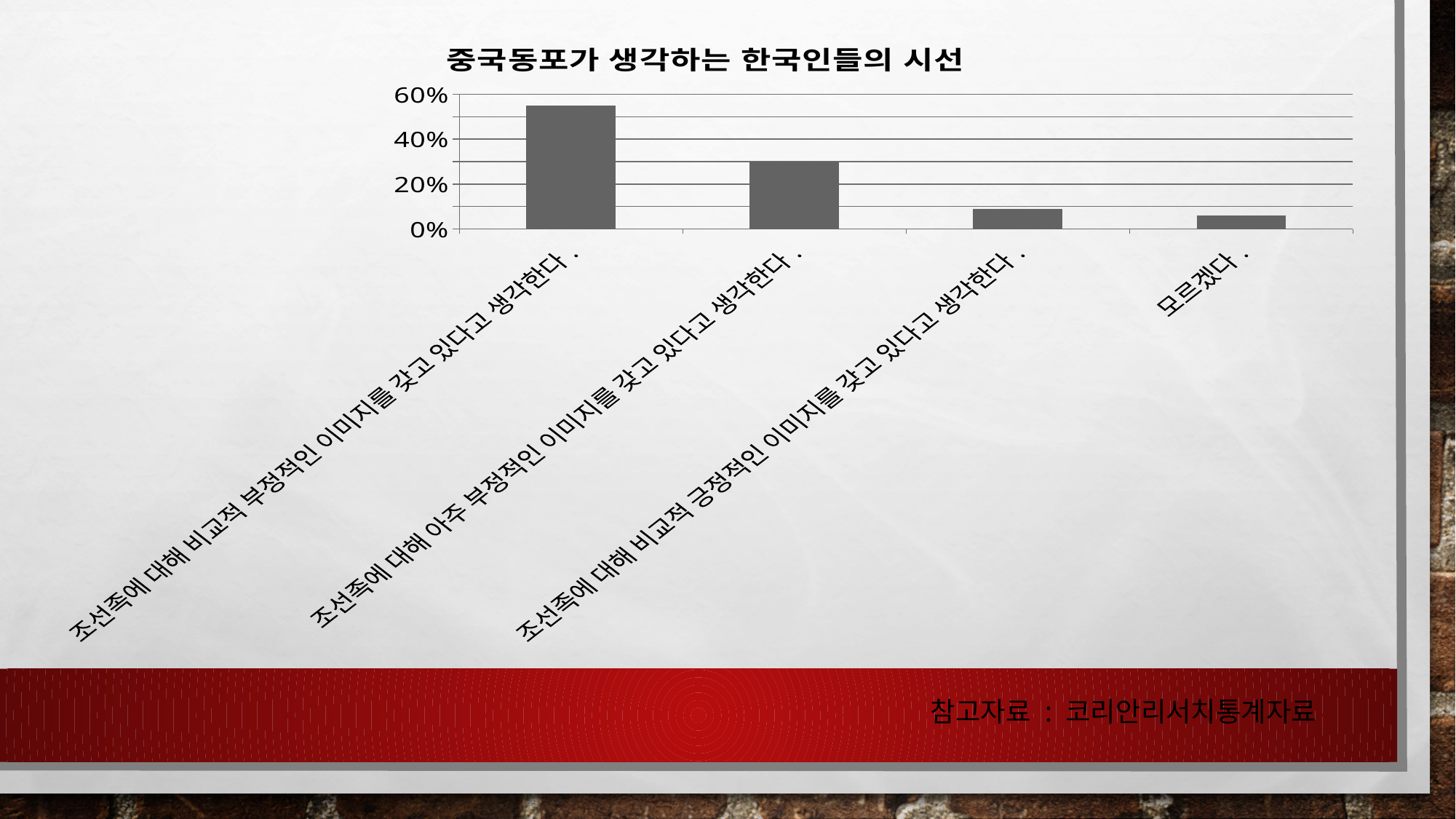
Is the value for '조선족에 대해 비교적 부정적인 이미지를 갖고 있다고 생각한다.' greater or less than 40%? greater What is the title of the chart? 중국동포가 생각하는 한국인들의 시선 Which category has the highest value? 조선족에 대해 비교적 부정적인 이미지를 갖고 있다고 생각한다. Which is larger: the value for '조선족에 대해 아주 부정적인 이미지를 갖고 있다고 생각한다.' or for '조선족에 대해 비교적 긍정적인 이미지를 갖고 있다고 생각한다.'? 조선족에 대해 아주 부정적인 이미지를 갖고 있다고 생각한다. Is the value for '조선족에 대해 아주 부정적인 이미지를 갖고 있다고 생각한다.' greater or less than 20%? greater Is the value for '조선족에 대해 아주 부정적인 이미지를 갖고 있다고 생각한다.' greater or less than 40%? less Do the bar values rise or fall from left to right along the x axis? fall What kind of chart is shown on the slide? bar chart Which is larger: the value for '조선족에 대해 비교적 부정적인 이미지를 갖고 있다고 생각한다.' or for '조선족에 대해 아주 부정적인 이미지를 갖고 있다고 생각한다.'? 조선족에 대해 비교적 부정적인 이미지를 갖고 있다고 생각한다. How many categories are plotted in the chart? 4